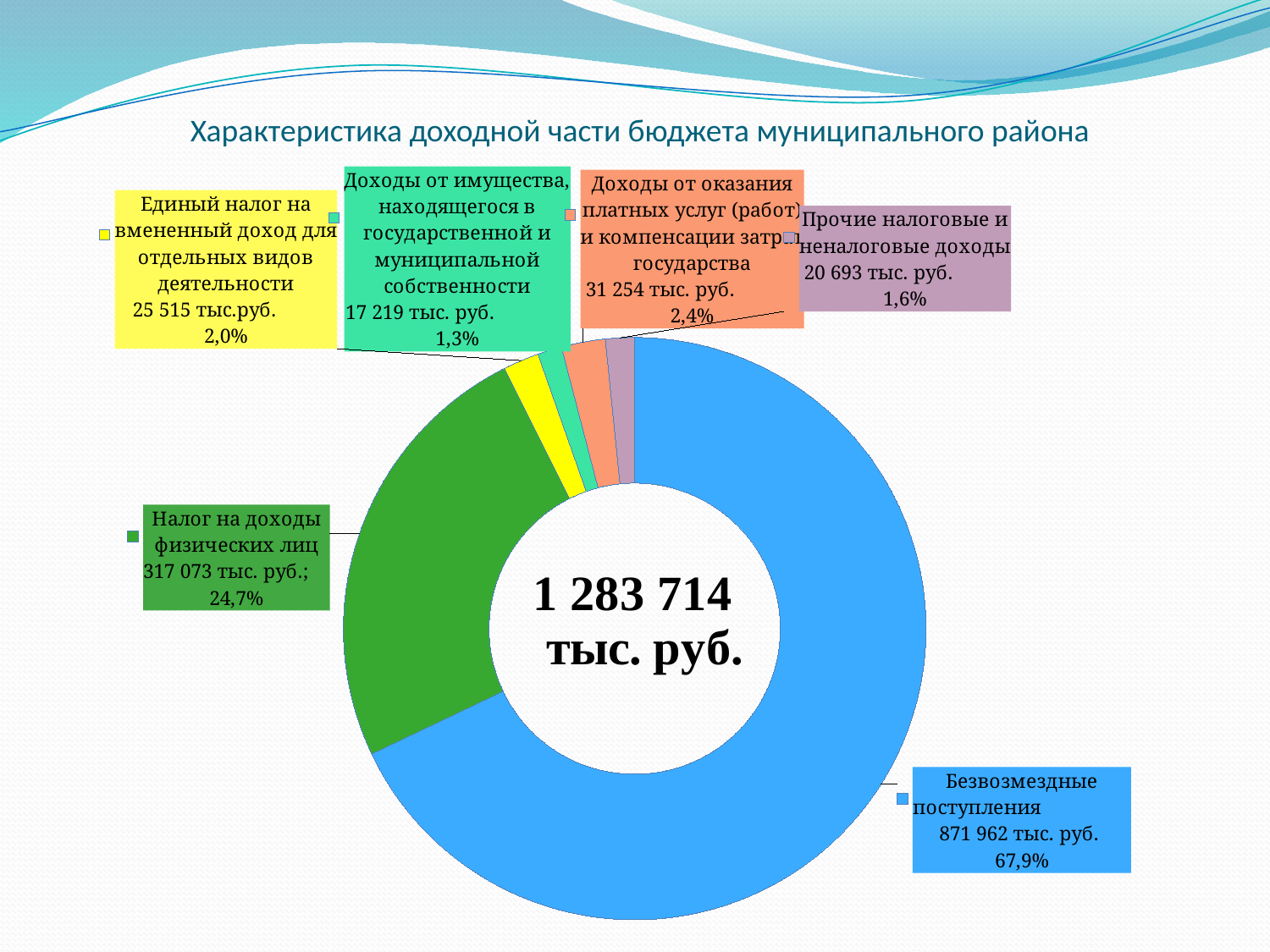
What share of the chart does Налог на доходы физических лиц represent? 24,7% Which category has the largest share of the chart? Безвозмездные поступления How many categories are shown in the chart? 6 What share of the chart does Прочие налоговые и неналоговые доходы represent? 1,6% Which is larger: Единый налог на вмененный доход для отдельных видов деятельности or Доходы от оказания платных услуг (работ) и компенсации затрат государства? Доходы от оказания платных услуг (работ) и компенсации затрат государства Which category has the smallest share of the chart? Доходы от имущества, находящегося в государственной и муниципальной собственности What is the value for Доходы от оказания платных услуг (работ) и компенсации затрат государства? 31 254 тыс. руб. What is the title of the chart on the slide? Характеристика доходной части бюджета муниципального района What is the value for Безвозмездные поступления? 871 962 тыс. руб. What total value is printed in the centre of the doughnut chart? 1 283 714 тыс. руб. What is the difference in value between Безвозмездные поступления and Налог на доходы физических лиц? 554 889 тыс. руб. What kind of chart is shown on the slide? Doughnut (pie) chart